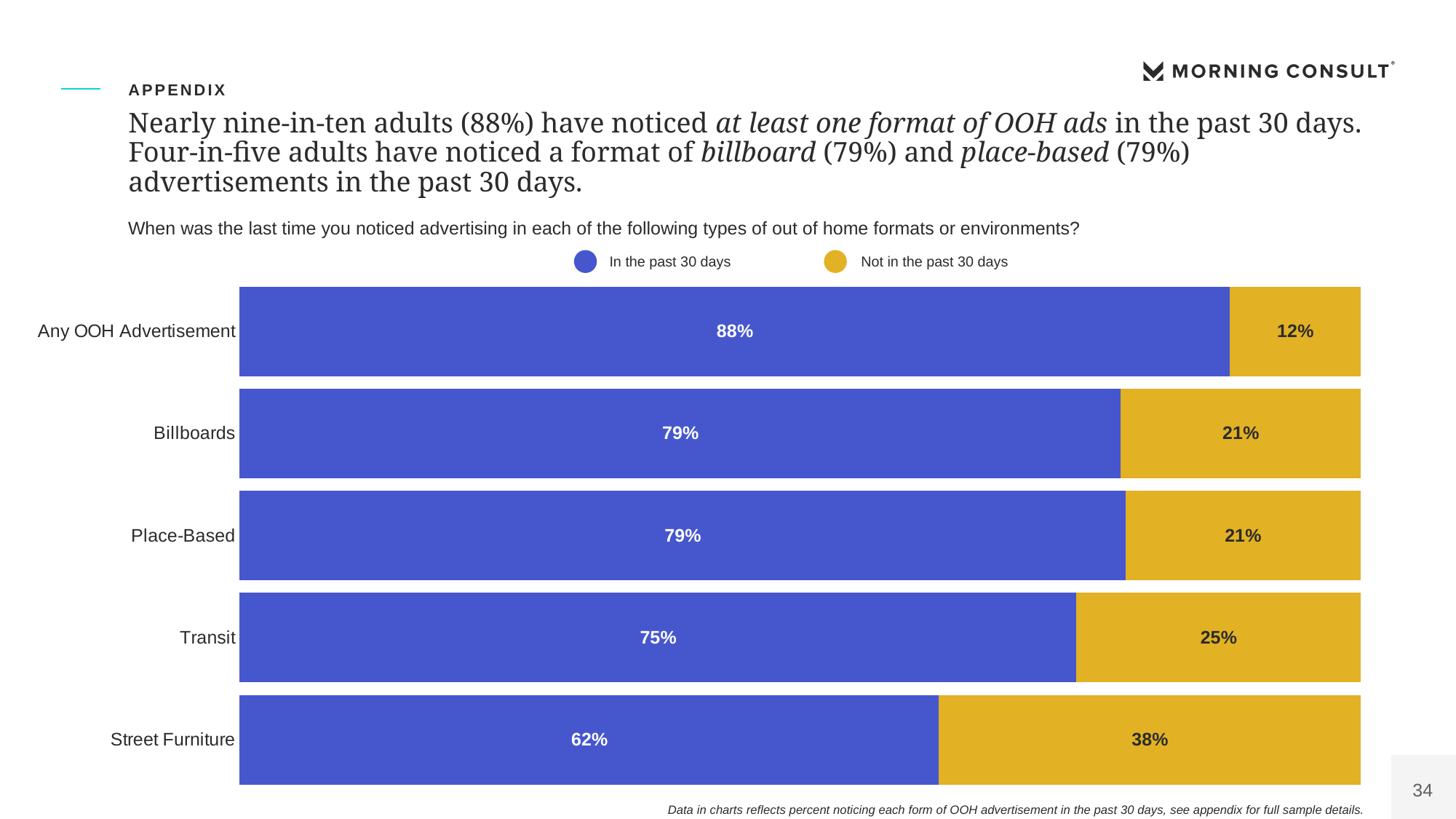
Which is larger: the 'In the past 30 days' value for Transit or for Street Furniture? Transit What is the 'Not in the past 30 days' value for Street Furniture? 38% What is the 'In the past 30 days' value for Transit? 75% Which category has the highest 'Not in the past 30 days' value? Street Furniture How many series does the legend list? 2 What is the total of the stacked bar for Place-Based? 100% What kind of chart is shown on the slide? Stacked bar chart How many categories are shown on the chart? 5 What percentage of adults noticed Any OOH Advertisement in the past 30 days? 88% Which category has the lowest 'In the past 30 days' value? Street Furniture Which colour represents 'Not in the past 30 days' in the legend? Yellow What is the difference between the 'In the past 30 days' values for Billboards and Transit? 4%